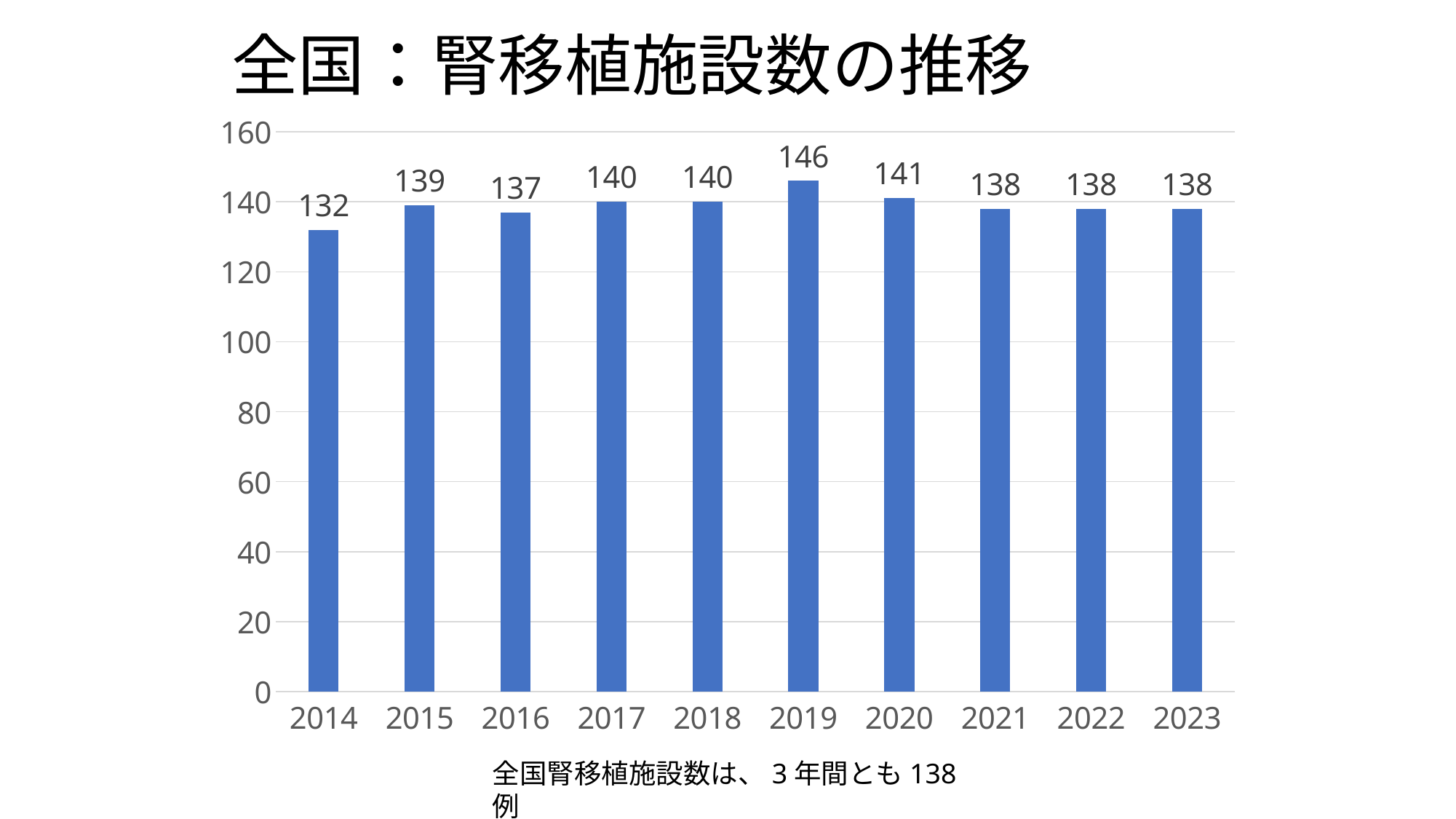
What is the difference between the values for 2020 and 2021? 3 What is the title of the chart? 全国：腎移植施設数の推移 Which year has the lowest value? 2014 What is the value for 2014? 132 What is the value for 2023? 138 What is the difference between the values for 2019 and 2014? 14 What kind of chart is this? bar chart Which year has the highest value? 2019 How many years are shown on the x axis? 10 What is the value for 2019? 146 Which is larger, the value for 2016 or the value for 2017? 2017 Is the value for 2014 greater or less than 140? less